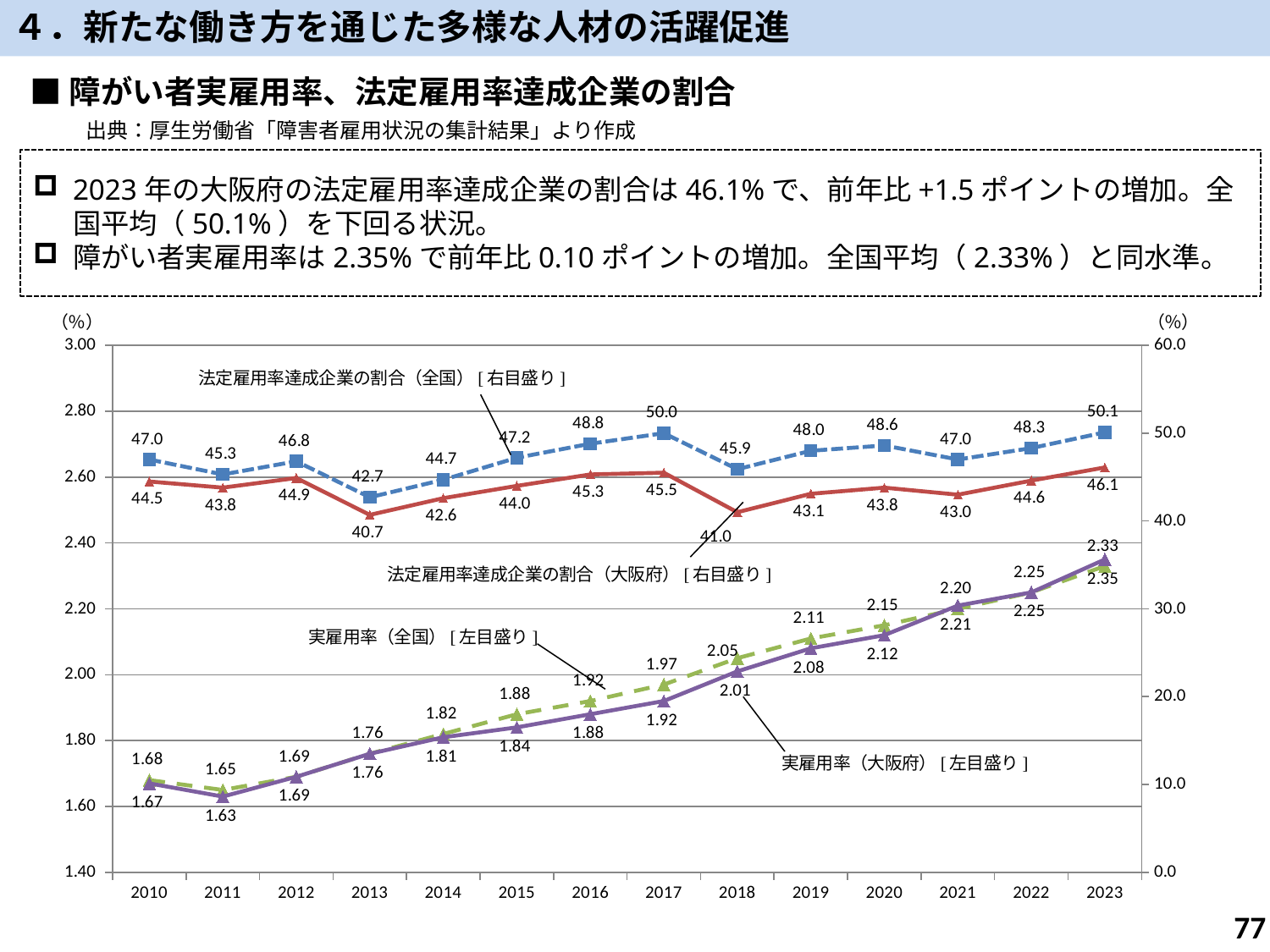
2023年の実雇用率（大阪府）の値はいくつですか？ 2.35 実雇用率（大阪府）が最も低かった年はいつですか？ 2011 横軸には何年分のデータ点がありますか？ 14 2023年の法定雇用率達成企業の割合（大阪府）の値はいくつですか？ 46.1 法定雇用率達成企業の割合（大阪府）が最も低かった年はいつですか？ 2013 2017年の法定雇用率達成企業の割合（全国）の値はいくつですか？ 50.0 法定雇用率達成企業の割合（全国）が最も高かった年はいつですか？ 2023 実雇用率（全国）は2010年から2023年にかけて全体として上昇していますか、下降していますか？ 上昇 このグラフには何本の系列（線）が描かれていますか？ 4 2023年の法定雇用率達成企業の割合について、全国と大阪府の差は何ポイントですか？ 4.0 2018年の法定雇用率達成企業の割合は、全国と大阪府のどちらが高いですか？ 全国 このグラフはどの種類のグラフですか？ 折れ線グラフ